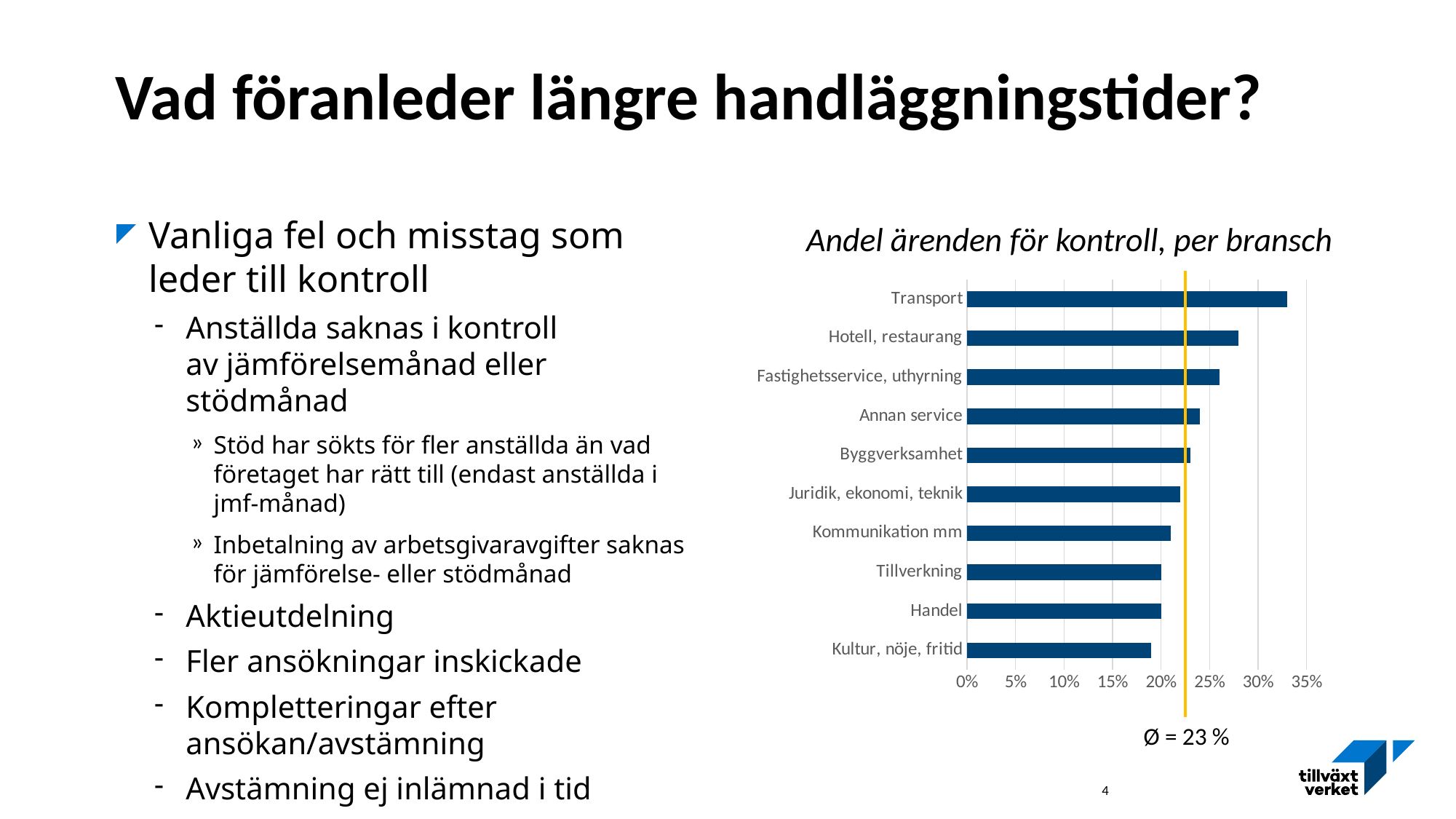
What is the title of the chart? Andel ärenden för kontroll, per bransch Which has a larger share of cases for control, Annan service or Tillverkning? Annan service Which industry has the highest share of cases for control? Transport Is the value for Hotell, restaurang greater or less than 25%? greater Which has a larger share of cases for control, Transport or Hotell, restaurang? Transport Is the value for Juridik, ekonomi, teknik greater or less than 25%? less How many industries (categories) are shown in the chart? 10 Which industry has the lowest share of cases for control? Kultur, nöje, fritid Is the value for Transport greater or less than 30%? greater What average value is marked by the vertical line in the chart? Ø = 23 % What kind of chart is shown on the slide? Bar chart